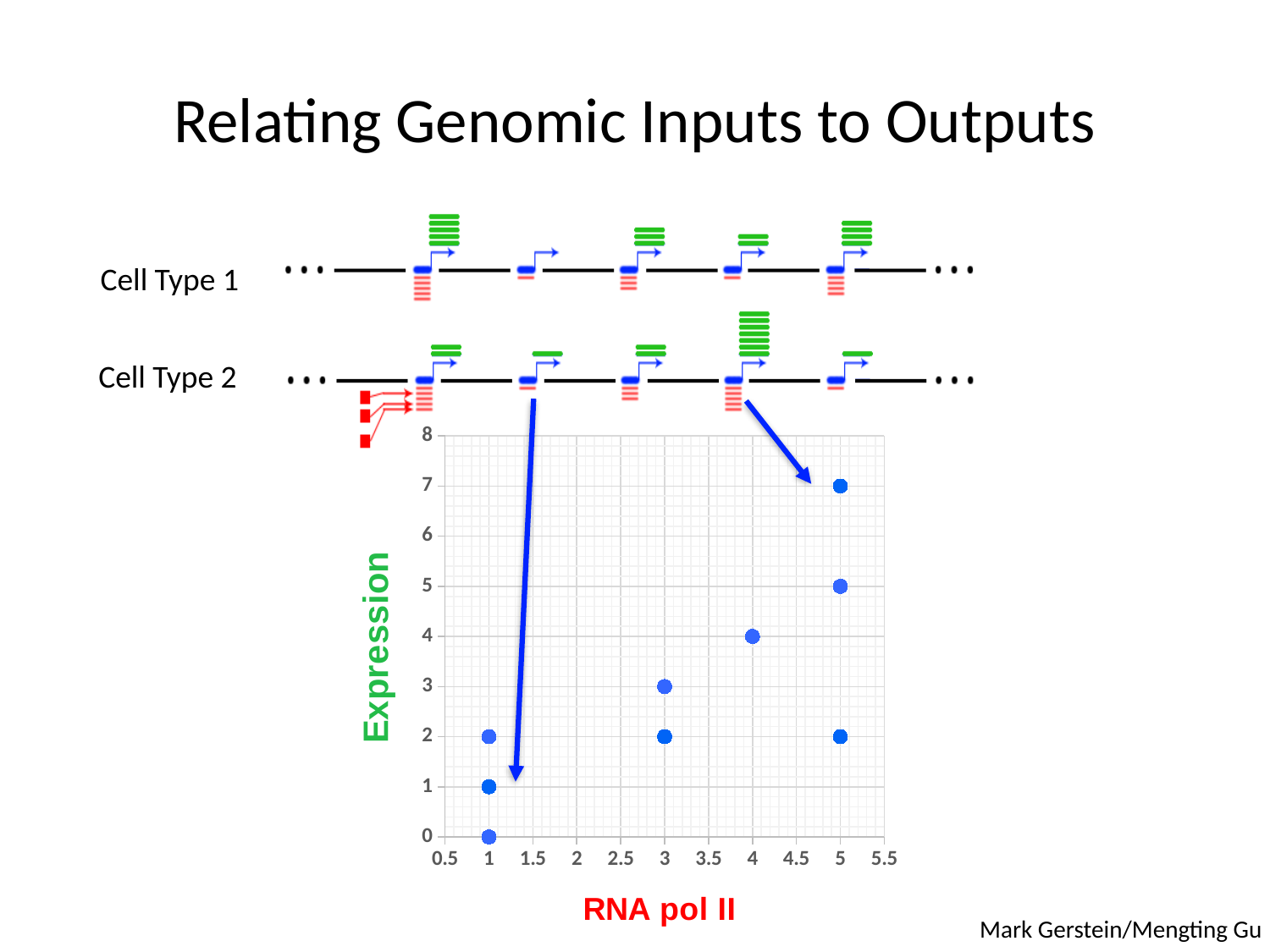
How many points are plotted at RNA pol II = 5? 3 What is the Expression value of the single point plotted at RNA pol II = 4? 4 What is the lowest Expression value plotted in the scatter chart? 0 What is the label of the x axis of the scatter chart? RNA pol II At what RNA pol II value does the point with the highest Expression lie? 5 How many points are plotted at RNA pol II = 1? 3 Overall, does Expression tend to rise or fall as RNA pol II increases along the x axis? rise How many data points are plotted in the scatter chart? 9 What is the label of the y axis of the scatter chart? Expression What is the highest Expression value plotted in the scatter chart? 7 What is the difference between the highest and lowest Expression values plotted at RNA pol II = 5? 5 What kind of chart is shown on the slide? scatter chart